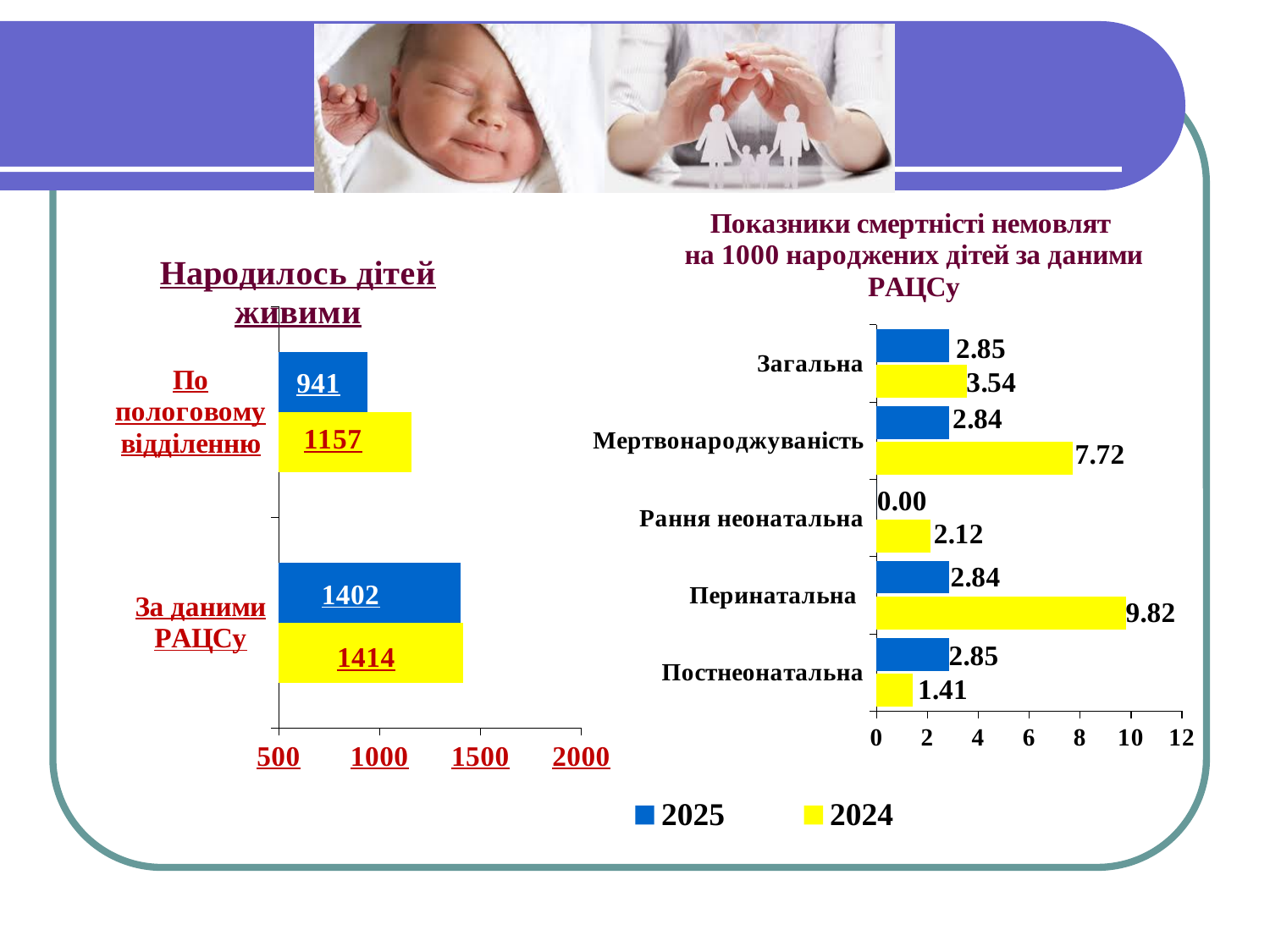
In the chart titled "Показники смертністі немовлят на 1000 народжених дітей за даними РАЦСу", what is the 2025 value for "Рання неонатальна"? 0.00 In the chart titled "Народилось дітей живими", what is the 2025 value for "По пологовому відділенню"? 941 In the chart titled "Показники смертністі немовлят на 1000 народжених дітей за даними РАЦСу", how many categories are shown? 5 In the chart titled "Народилось дітей живими", what is the difference between the 2024 and 2025 values for "По пологовому відділенню"? 216 In the chart titled "Народилось дітей живими", which is larger for "За даними РАЦСу": the 2025 value or the 2024 value? 2024 In the chart titled "Показники смертністі немовлят на 1000 народжених дітей за даними РАЦСу", what is the difference between the 2024 and 2025 values for "Мертвонароджуваність"? 4.88 In the chart titled "Показники смертністі немовлят на 1000 народжених дітей за даними РАЦСу", which category has the highest 2024 value? Перинатальна In the chart titled "Показники смертністі немовлят на 1000 народжених дітей за даними РАЦСу", what is the 2024 value for "Перинатальна"? 9.82 What kind of chart is the chart titled "Показники смертністі немовлят на 1000 народжених дітей за даними РАЦСу"? Bar chart In the chart titled "Народилось дітей живими", how many categories are shown? 2 In the chart titled "Народилось дітей живими", what is the 2024 value for "За даними РАЦСу"? 1414 In the chart titled "Показники смертністі немовлят на 1000 народжених дітей за даними РАЦСу", which category has the lowest 2024 value? Постнеонатальна